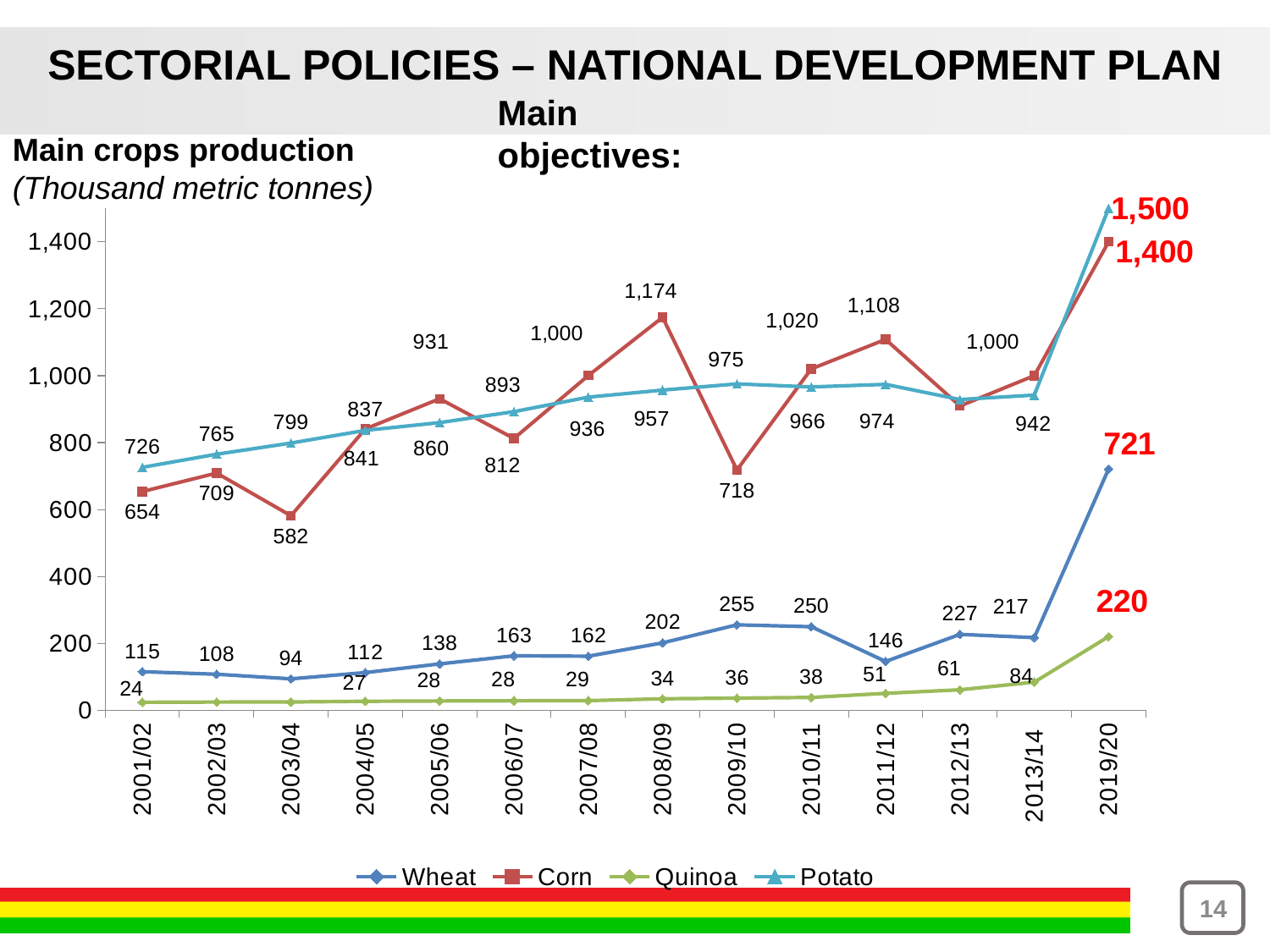
Which crop has the highest production value in 2019/20? Potato Is the Corn value for 2012/13 greater or less than 1,000? less How many series does the legend list? 4 What is the Wheat production value for 2009/10? 255 Which is larger in 2008/09, Corn or Potato production? Corn How many years are shown along the x axis? 14 What is the Potato production value for 2019/20? 1,500 In what units is crop production measured on the chart? Thousand metric tonnes By how much does Corn production in 2019/20 exceed its 2013/14 value? 400 What is the Corn production value for 2008/09? 1,174 What kind of chart is shown on the slide? Line chart In which year is Wheat production at its lowest? 2003/04